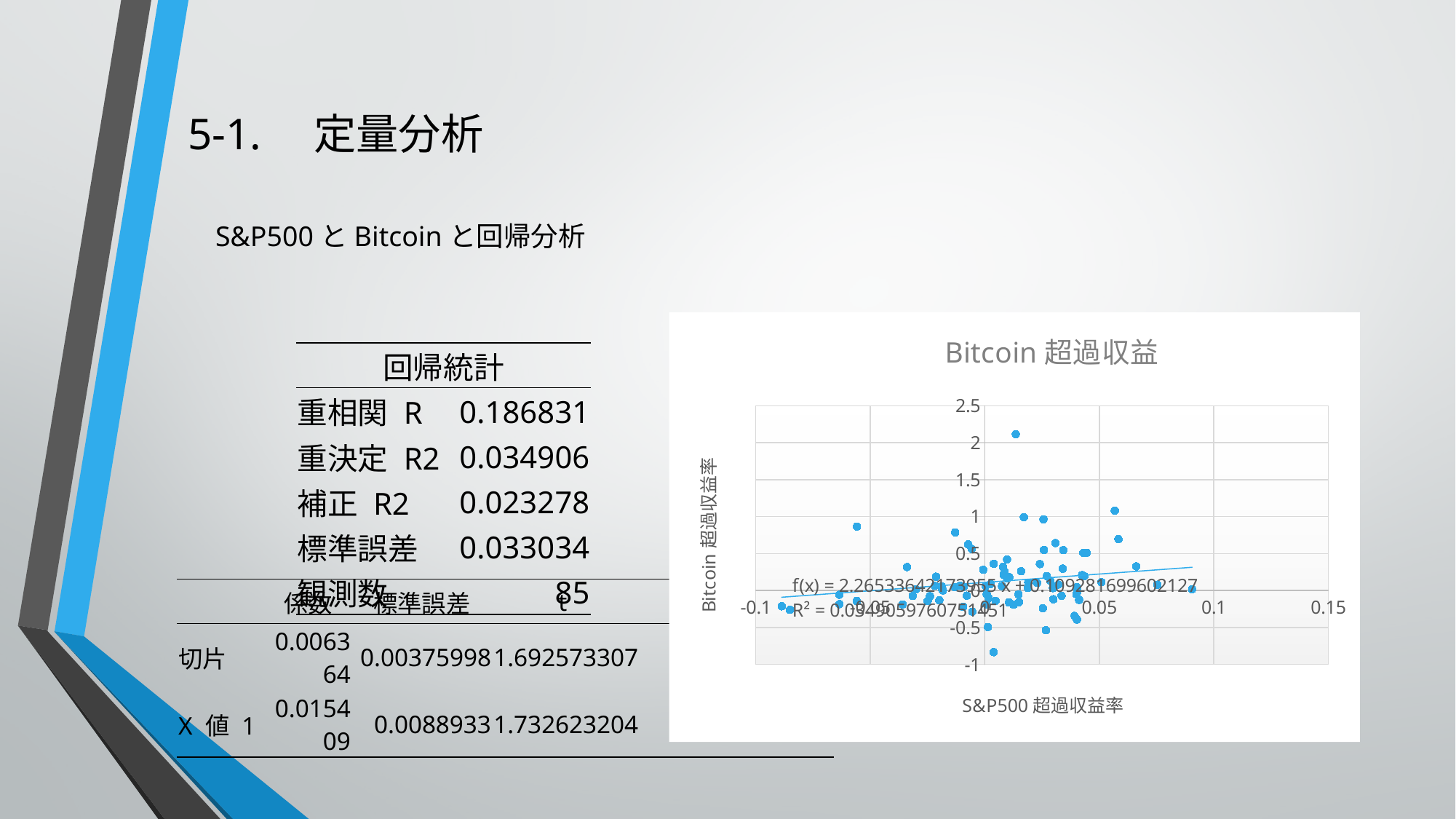
Is the highest point on the chart located at an x value greater or less than 0? greater What is the highest tick value shown on the vertical axis of the chart? 2.5 What is the highest tick value shown on the horizontal axis of the chart? 0.15 What is the title of the chart on the slide? Bitcoin 超過収益 Is the lowest point on the chart greater or less than -0.5 on the vertical axis? less Is the highest point on the chart greater or less than 2 on the vertical axis? greater Does the trendline on the chart rise or fall as the x-axis value increases? rises What kind of chart is shown on the slide? scatter chart What is the label of the horizontal axis of the chart? S&P500 超過収益率 What is the lowest tick value shown on the horizontal axis of the chart? -0.1